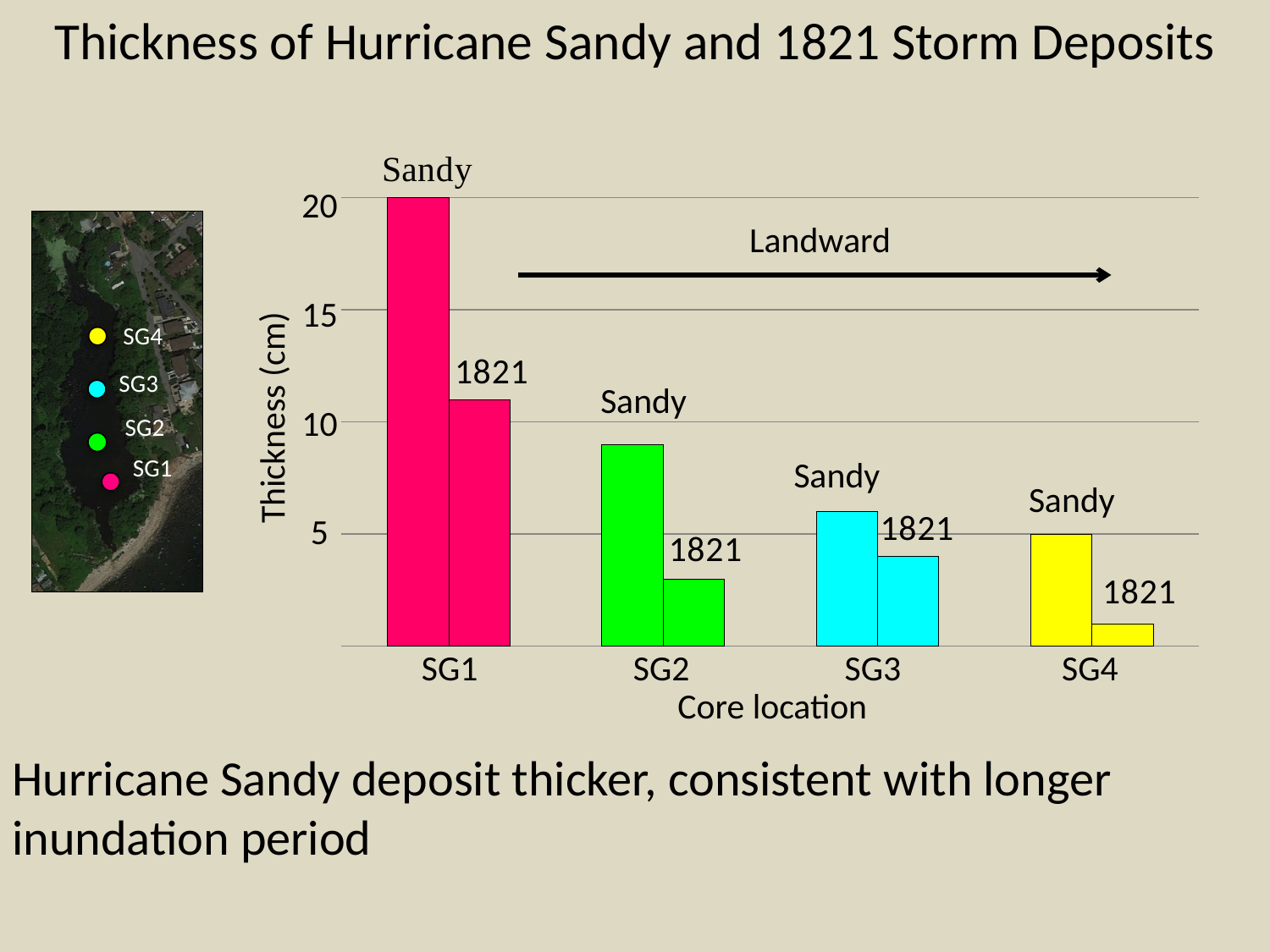
Is the thickness of the 1821 deposit at SG2 greater or less than 5? less Which core location has the thinnest 1821 deposit? SG4 Which core location has the thickest Sandy deposit? SG1 What is the thickness of the Sandy deposit at SG4? 5 Is the thickness of the Sandy deposit at SG2 greater or less than 10? less What is the thickness of the Sandy deposit at SG1? 20 Does the thickness of the Sandy deposit rise or fall from SG1 to SG4? fall How many core locations are shown on the x axis? 4 Is the thickness of the 1821 deposit at SG1 greater or less than 10? greater What is the difference in Sandy deposit thickness between SG1 and SG4? 15 At SG1, which deposit is thicker, Sandy or 1821? Sandy What kind of chart is shown on the slide? bar chart